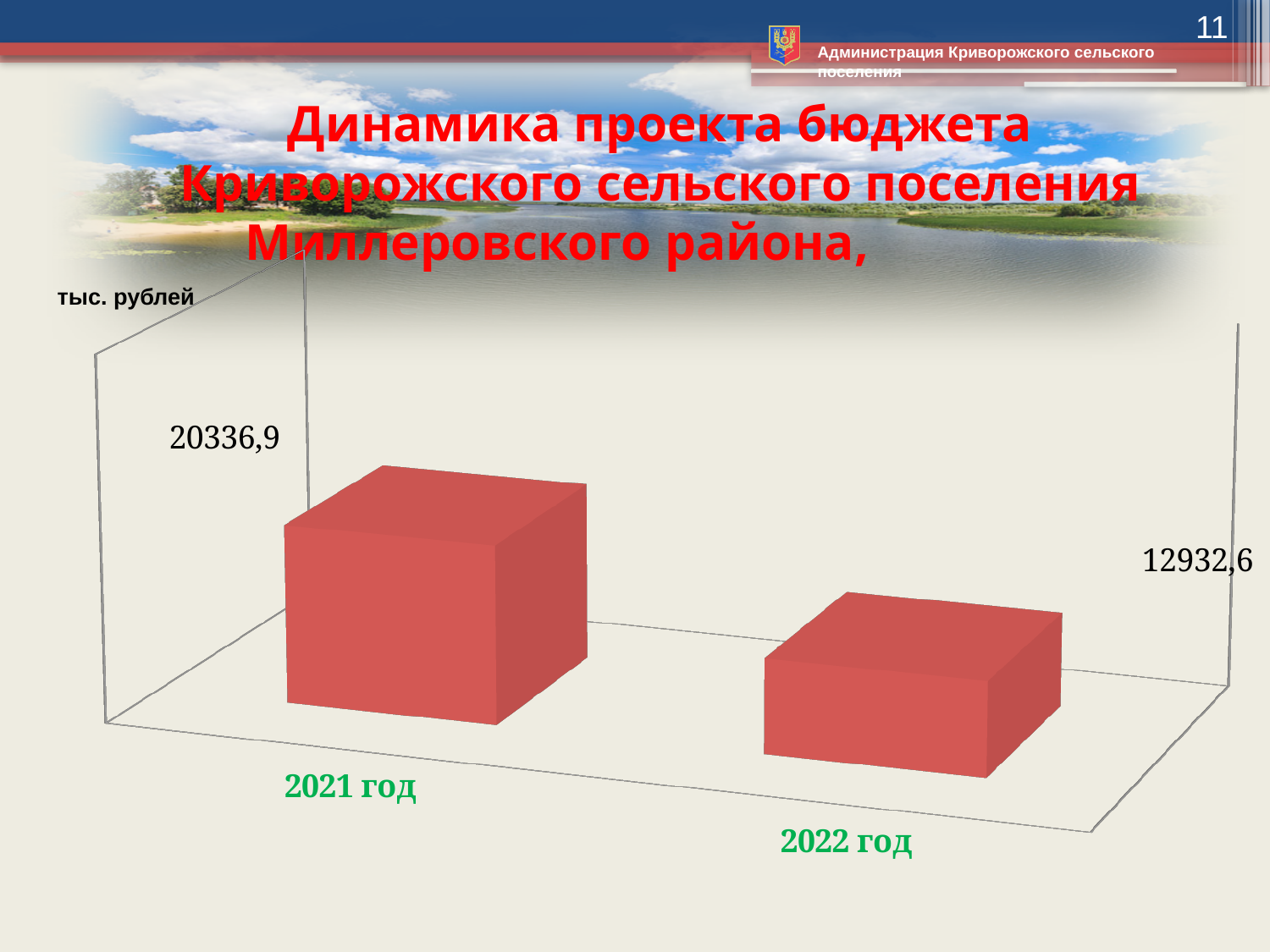
How many categories (years) are plotted on the chart? 2 In what units are the chart values expressed, according to the label on the slide? тыс. рублей Which year has the lowest value on the chart? 2022 год What kind of chart is shown on the slide? Bar chart Which is larger, the value for 2021 год or the value for 2022 год? 2021 год What is the value shown for 2021 год? 20336,9 What is the difference between the values for 2021 год and 2022 год? 7404,3 Do the values rise or fall from 2021 год to 2022 год? Fall Which year has the highest value on the chart? 2021 год What is the value shown for 2022 год? 12932,6 What colour are the bars on the chart? Red